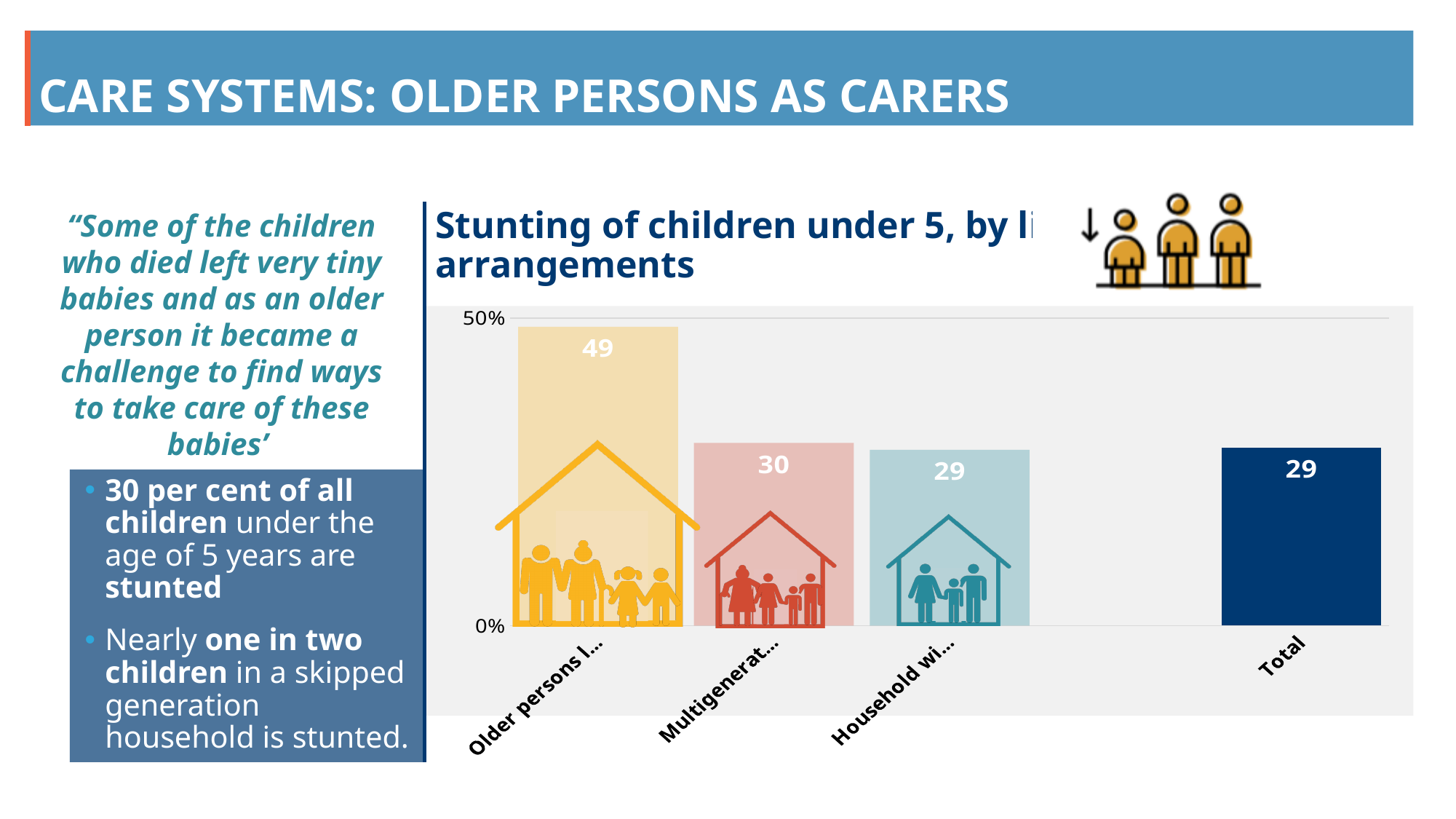
Which bar has the highest value: the first, second, third, or the Total bar? the first (leftmost) bar Which is larger, the value of the leftmost bar or the value of the second bar? the leftmost bar Is the value for the Total bar greater or less than 50%? less How many bars are plotted in the chart? 4 What value is shown on the bar labelled "Total"? 29 Do the values of the first three bars rise or fall from left to right? fall What value is shown on the second (red/pink) bar of the chart? 30 What value is shown on the third (light blue) bar of the chart? 29 What is the difference between the value of the second bar and the third bar? 1 What is the difference between the value of the leftmost bar and the Total bar? 20 What kind of chart is shown on the slide? bar chart What value is shown on the leftmost (yellow) bar of the chart? 49